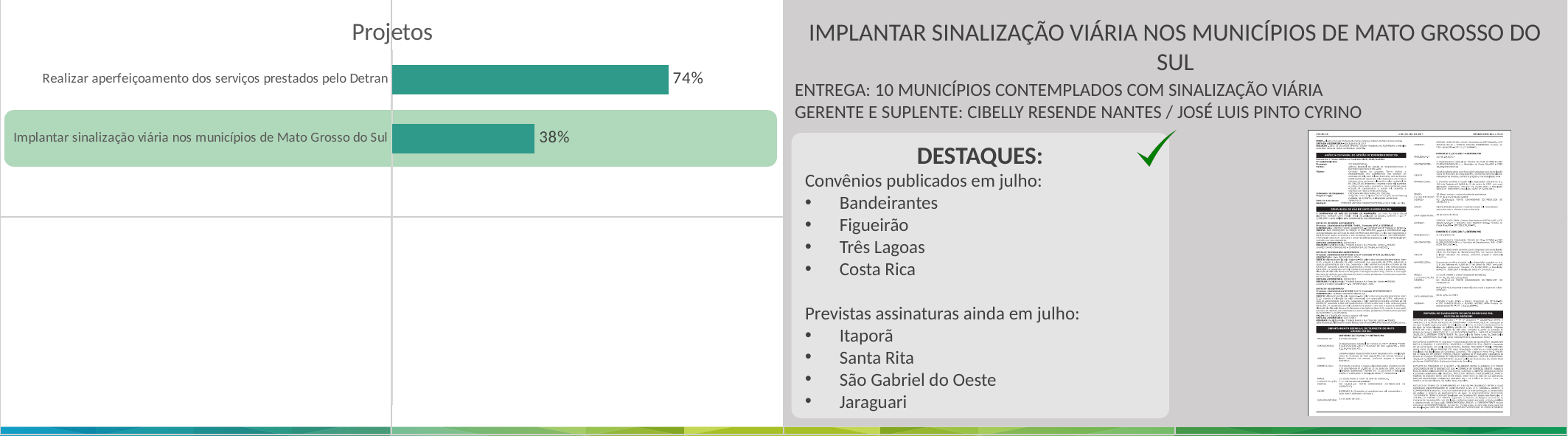
What is the title of the chart on the slide? Projetos In the "Projetos" chart, is the value for "Realizar aperfeiçoamento dos serviços prestados pelo Detran" greater or less than 50%? greater Which category has the highest value in the "Projetos" chart? Realizar aperfeiçoamento dos serviços prestados pelo Detran In the "Projetos" chart, what is the difference between the value for "Realizar aperfeiçoamento dos serviços prestados pelo Detran" and the value for "Implantar sinalização viária nos municípios de Mato Grosso do Sul"? 36% How many categories (bars) does the "Projetos" chart show? 2 What colour are the bars in the "Projetos" chart? teal (green) Which category has the lowest value in the "Projetos" chart? Implantar sinalização viária nos municípios de Mato Grosso do Sul In the "Projetos" chart, which is larger: the value for "Realizar aperfeiçoamento dos serviços prestados pelo Detran" or the value for "Implantar sinalização viária nos municípios de Mato Grosso do Sul"? Realizar aperfeiçoamento dos serviços prestados pelo Detran What kind of chart is shown under the title "Projetos"? bar chart What is the value for "Realizar aperfeiçoamento dos serviços prestados pelo Detran" in the "Projetos" chart? 74% What is the value for "Implantar sinalização viária nos municípios de Mato Grosso do Sul" in the "Projetos" chart? 38% In the "Projetos" chart, is the value for "Implantar sinalização viária nos municípios de Mato Grosso do Sul" greater or less than 50%? less